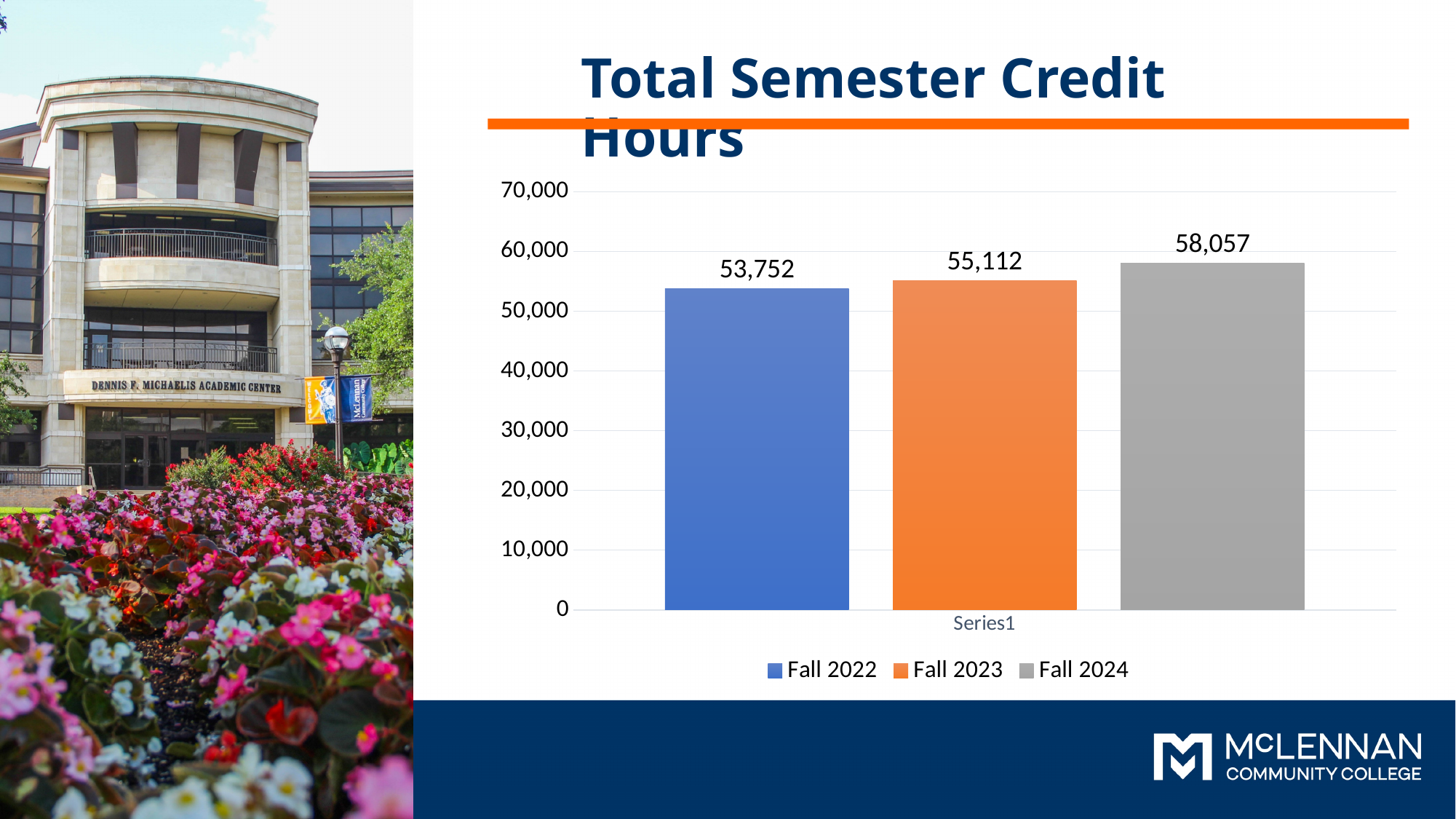
What is the difference in total semester credit hours between Fall 2024 and Fall 2022? 4,305 Which is larger, the credit hours for Fall 2023 or Fall 2024? Fall 2024 Is the value for Fall 2022 greater or less than 50,000? greater Which semester has the lowest total semester credit hours? Fall 2022 How many series does the legend list? 3 What is the total semester credit hours value for Fall 2023? 55,112 Do the total semester credit hours rise or fall from Fall 2022 to Fall 2024? Rise What is the total semester credit hours value for Fall 2024? 58,057 What is the total semester credit hours value for Fall 2022? 53,752 What kind of chart is shown on the slide? Bar chart Which semester has the highest total semester credit hours? Fall 2024 What is the difference in total semester credit hours between Fall 2023 and Fall 2022? 1,360